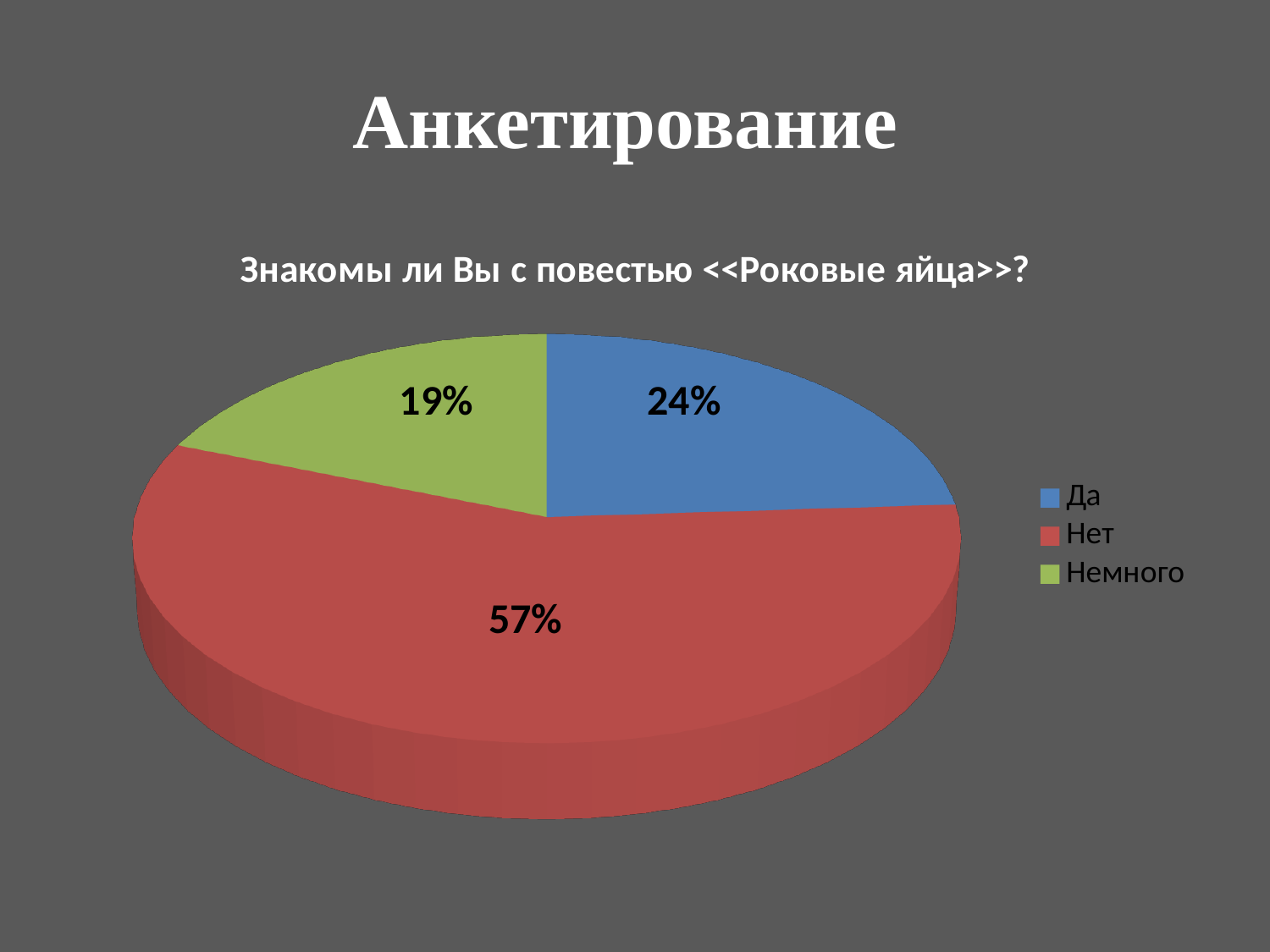
What is the title of the chart? Знакомы ли Вы с повестью <<Роковые яйца>>? What share of the pie does the "Да" slice represent? 24% How many categories does the pie chart have? 3 Which category has the largest slice of the pie? Нет What share of the pie does the "Немного" slice represent? 19% Which category has the smallest slice of the pie? Немного What kind of chart is shown on the slide? pie chart What is the difference in percentage points between the "Нет" and "Да" slices? 33 What colour is the "Нет" slice? red Which slice is larger, "Да" or "Немного"? Да What is the difference in percentage points between the "Да" and "Немного" slices? 5 What share of the pie does the "Нет" slice represent? 57%